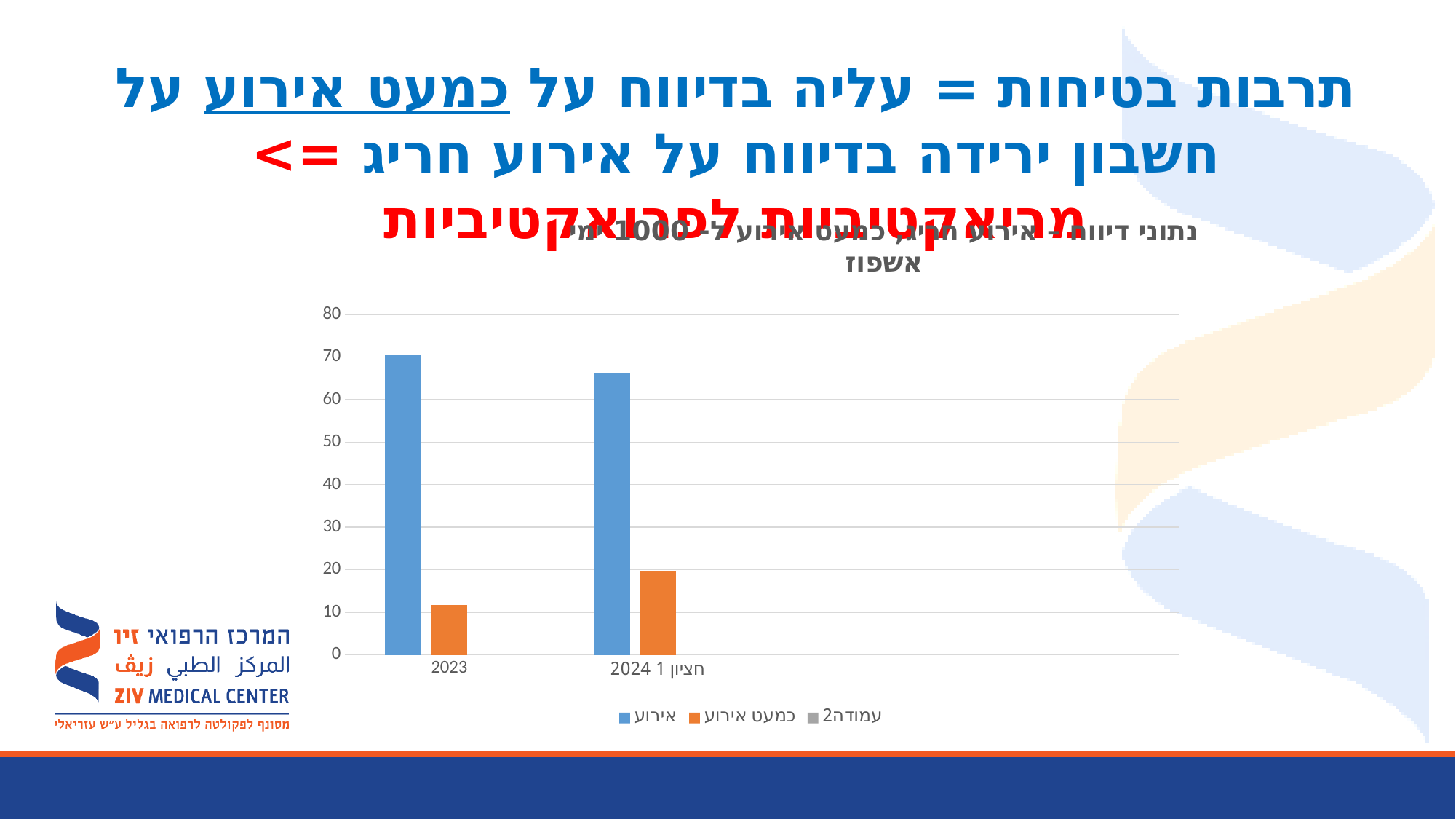
How many series does the chart legend list? 3 Which category has the higher value for כמעט אירוע, 2023 or חציון 1 2024? חציון 1 2024 Is the value for כמעט אירוע in 2023 greater or less than 20? less Is the value for אירוע in חציון 1 2024 greater or less than 60? greater Which colour represents the series אירוע in the chart? blue Which category has the higher value for אירוע, 2023 or חציון 1 2024? 2023 What kind of chart is shown on the slide? bar chart Is the value for אירוע in 2023 greater or less than 60? greater Does the value for אירוע rise or fall from 2023 to חציון 1 2024? fall How many categories are shown on the x axis of the chart? 2 Does the value for כמעט אירוע rise or fall from 2023 to חציון 1 2024? rise